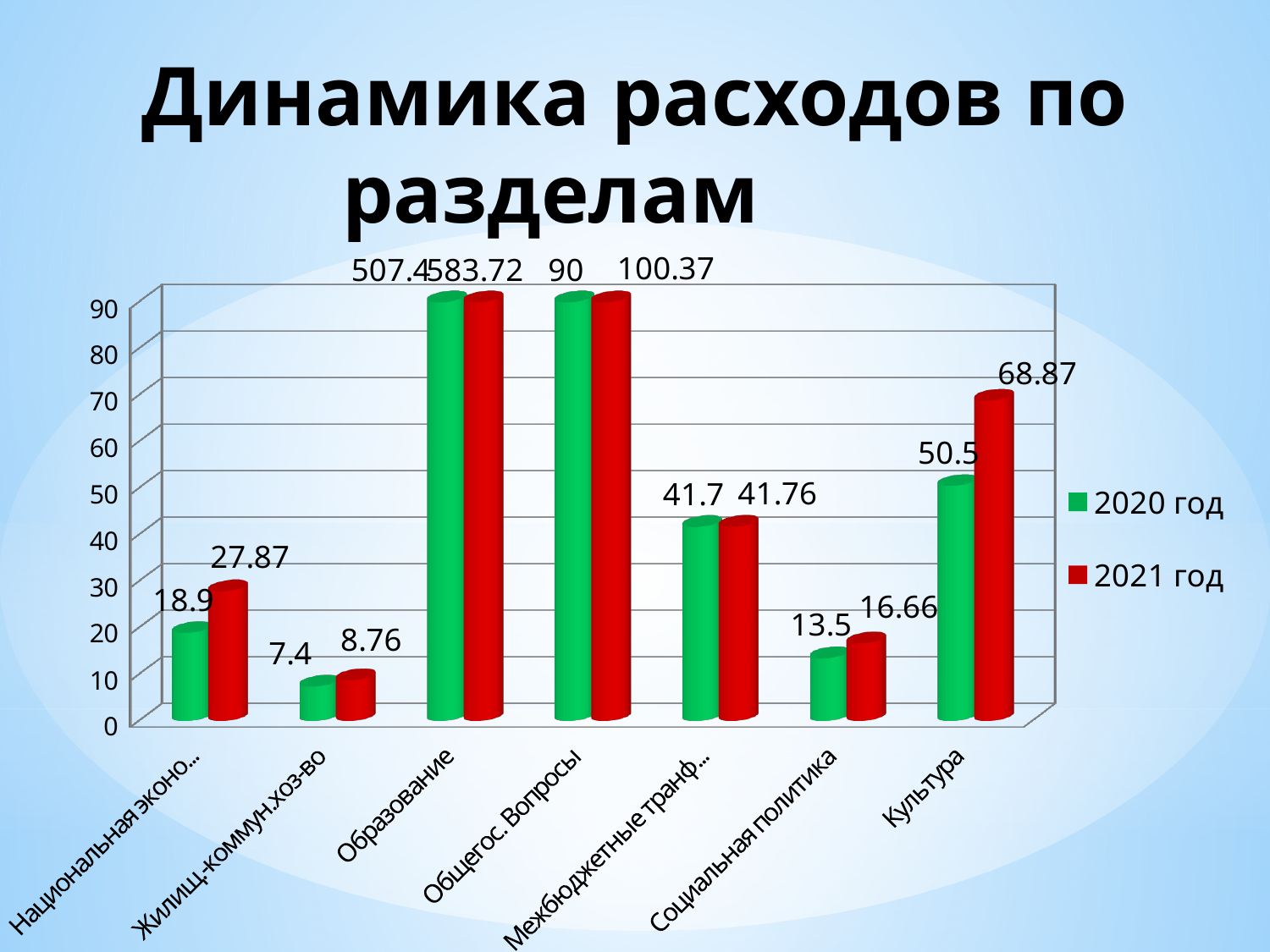
What is the difference between the 2021 год and 2020 год values for Культура? 18.37 What is the difference between the 2021 год and 2020 год values for Социальная политика? 3.16 How many series does the legend list? 2 Which category has the lowest value in the 2020 год series? Жилищ.-коммун.хоз-во Which category has the highest value in the 2021 год series? Образование What is the value for Жилищ.-коммун.хоз-во in the 2020 год series? 7.4 What kind of chart is shown on the slide? Bar chart What is the value for Социальная политика in the 2021 год series? 16.66 What is the value for Общегос. Вопросы in the 2021 год series? 100.37 Which is larger for Культура: the 2020 год value or the 2021 год value? 2021 год How many categories are shown on the x axis? 7 What is the value for Культура in the 2020 год series? 50.5